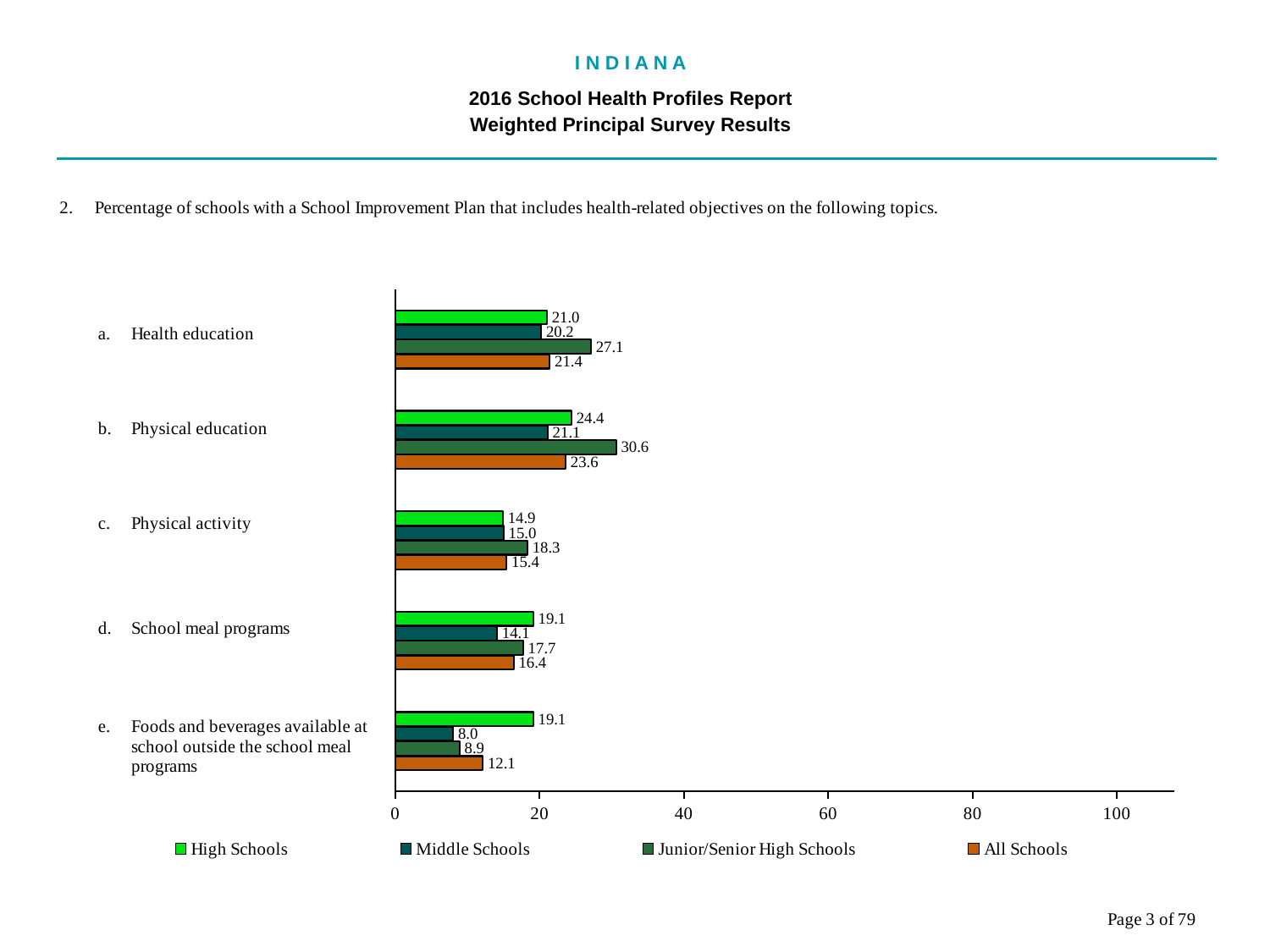
What is the value for All Schools for Health education? 21.4 What is the difference between the Junior/Senior High Schools and Middle Schools values for Physical education? 9.5 What kind of chart is shown on the slide? bar chart Which series is shown in orange in the legend? All Schools What is the value for Middle Schools for Foods and beverages available at school outside the school meal programs? 8.0 How many topics are shown on the chart? 5 Which topic has the highest value for High Schools? Physical education Which is larger for School meal programs: the High Schools value or the Middle Schools value? High Schools What is the value for Junior/Senior High Schools for Physical education? 30.6 Which topic has the lowest value for All Schools? Foods and beverages available at school outside the school meal programs Is the value for Junior/Senior High Schools for Physical education greater or less than 20? greater How many series does the legend list? 4